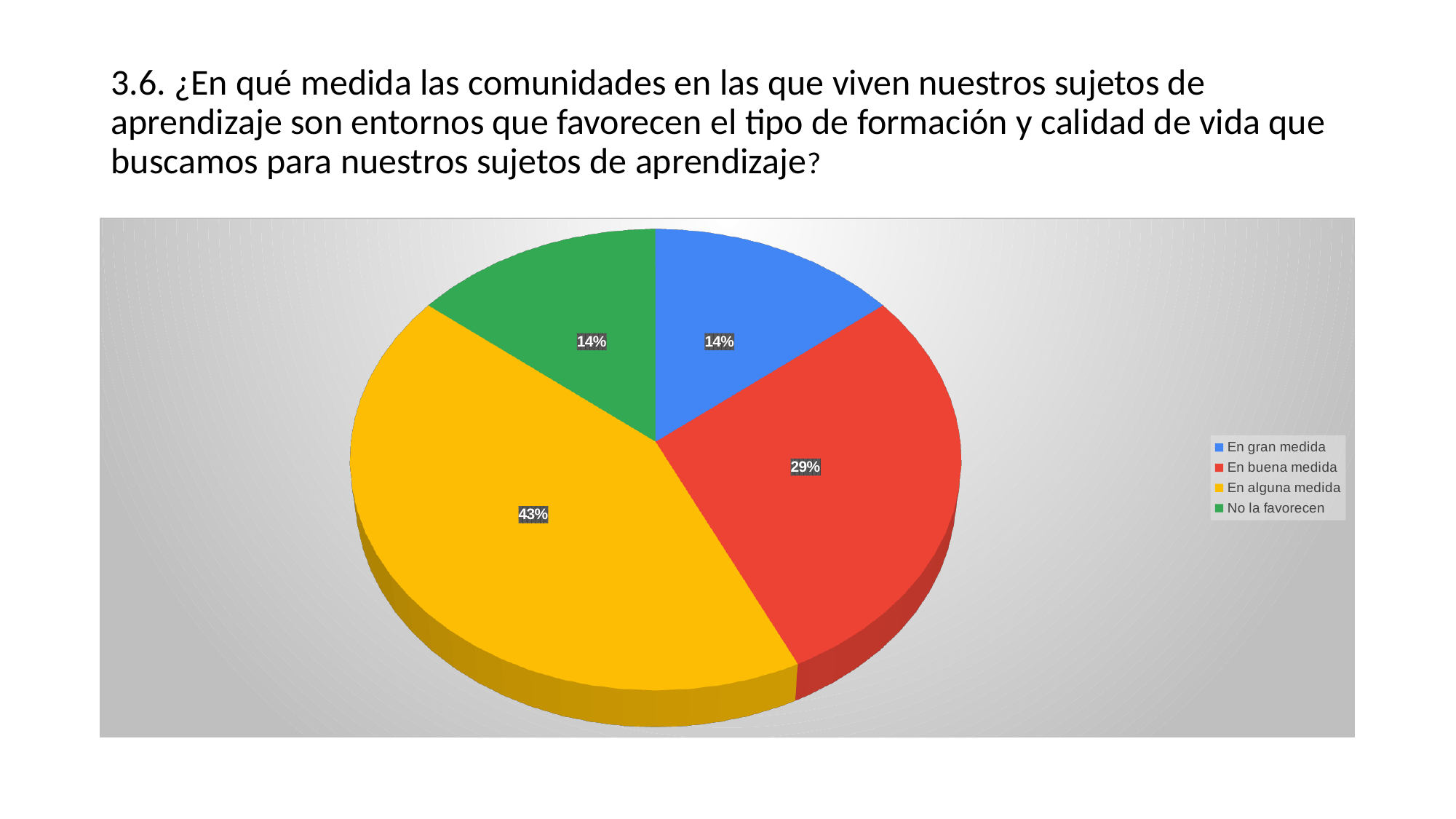
Which is larger, the slice for "En buena medida" or the slice for "En gran medida"? En buena medida What share of the pie does "En gran medida" represent? 14% What kind of chart is shown on the slide? Pie chart What is the difference in percentage points between "En alguna medida" and "En buena medida"? 14 What share of the pie does "En alguna medida" represent? 43% How many categories are shown in the pie chart? 4 Which category has the largest slice of the pie? En alguna medida Which category is shown in blue in the legend? En gran medida What share of the pie does "No la favorecen" represent? 14% Which colour represents "No la favorecen" in the legend? Green What is the difference in percentage points between "En buena medida" and "No la favorecen"? 15